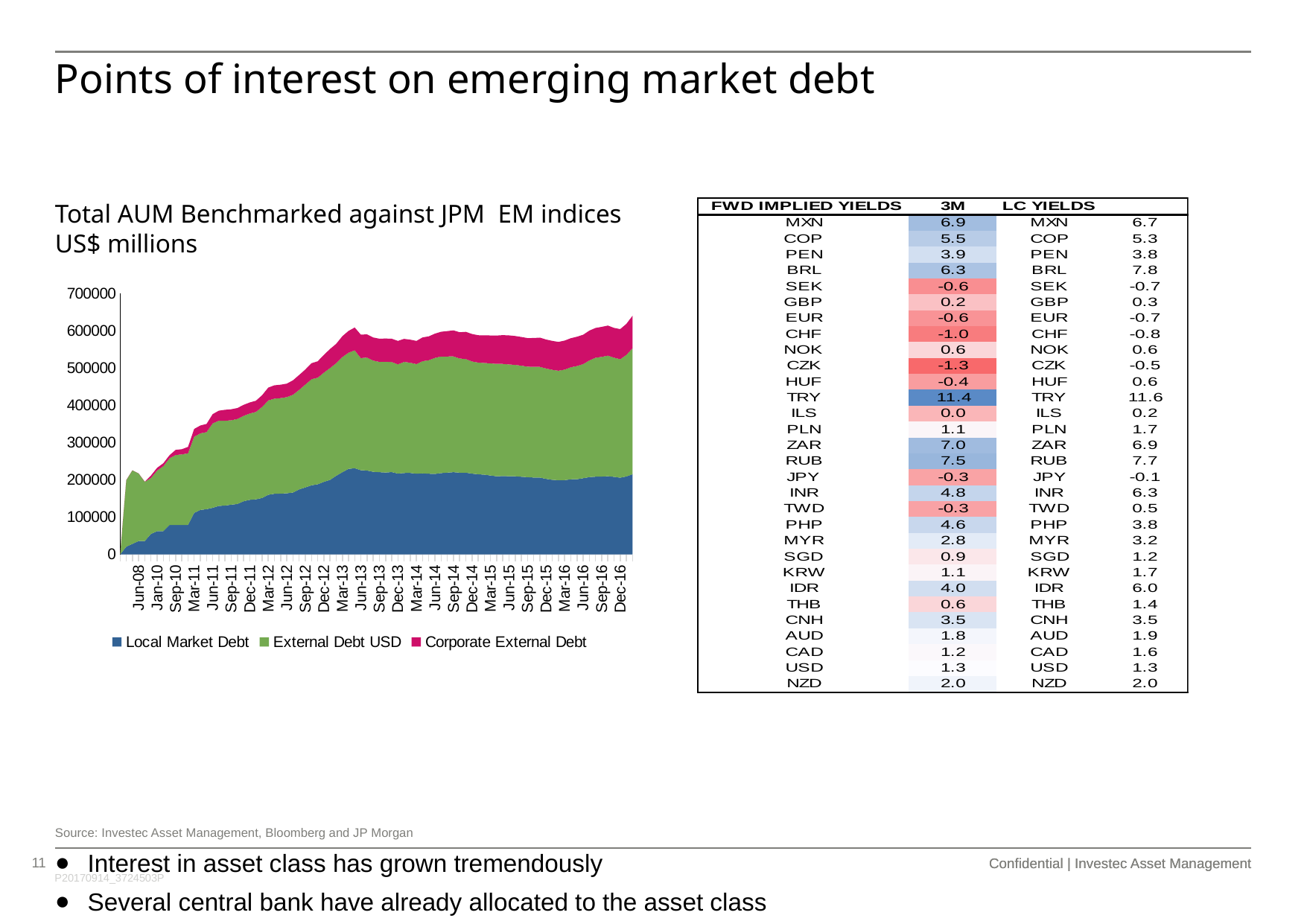
At Dec-16, which series contributes the largest band to the stack? External Debt USD Is the value for Local Market Debt at Jun-08 greater or less than 100000? less Is the total stacked value at Jun-08 greater or less than 300000? less At Dec-16, which series contributes the smallest band to the stack? Corporate External Debt What is the title of the chart? Total AUM Benchmarked against JPM EM indices US$ millions Does the total AUM in the chart rise or fall from Jun-08 to Dec-16? Rise Which series is shown in green in the chart? External Debt USD How many series does the chart legend list? 3 What kind of chart is shown on the slide? Stacked area chart What is the highest value shown on the chart's y axis? 700000 At Dec-16, which series has the larger value: Local Market Debt or Corporate External Debt? Local Market Debt